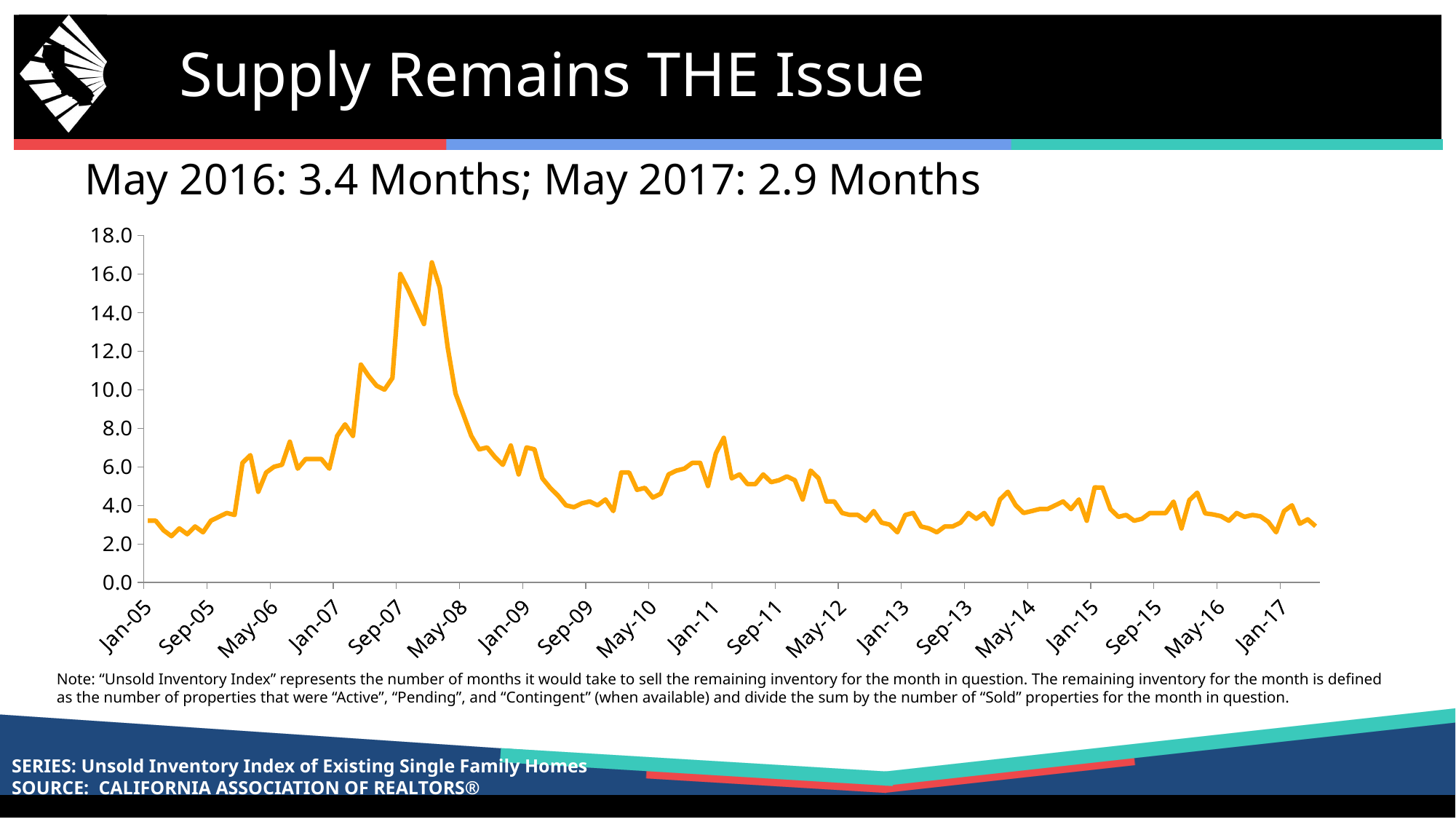
What is the highest value shown on the vertical axis? 18.0 What was the Unsold Inventory Index value in May 2016? 3.4 Months Is the peak value of the line, reached in early 2008, greater or less than 14.0? greater What kind of chart is shown on the slide? line chart Does the line generally rise or fall between Sep-07 and Sep-09? fall Is the value for Jan-11 greater or less than 6.0? greater What was the Unsold Inventory Index value in May 2017? 2.9 Months By how many months did the Unsold Inventory Index fall from May 2016 to May 2017? 0.5 months Between which two labeled x-axis dates does the line reach its highest point? Sep-07 and May-08 How many data series are plotted on the chart? 1 Which was higher, the Unsold Inventory Index in May 2016 or in May 2017? May 2016 Is the value for Jan-13 greater or less than 4.0? less